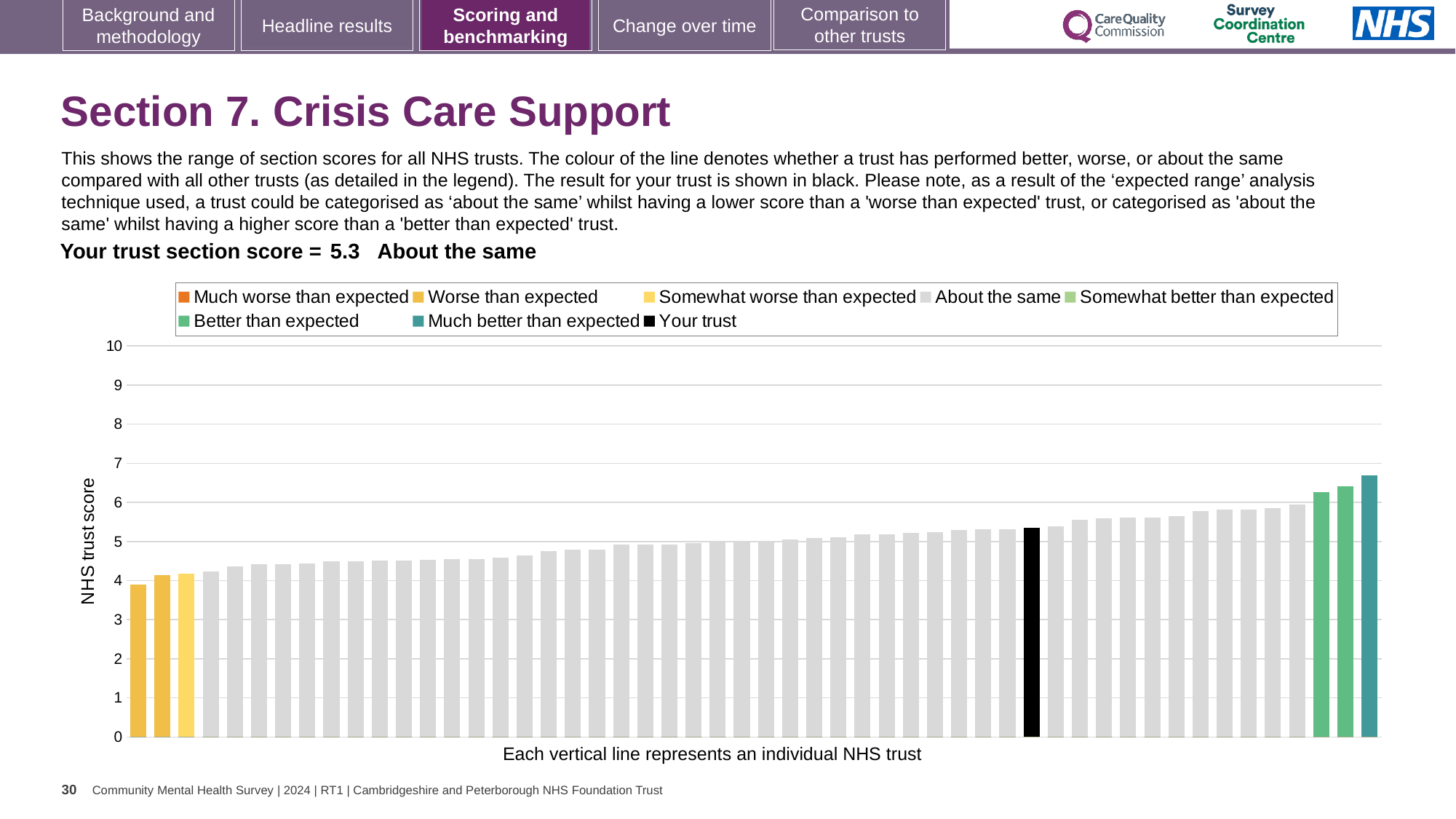
What is the label on the y axis of the chart? NHS trust score Do the bar values rise or fall from left to right along the x axis? rise What is the section score for your trust shown on the slide? 5.3 What kind of chart is shown on the slide? Bar chart Is the value of the tallest bar (rightmost) greater or less than 6? greater How many bars on the right are coloured in the 'better than expected' shades (green/teal)? 3 How many entries does the chart legend list? 8 Is the value for your trust (the black bar) greater or less than 5? greater Which is higher: the rightmost bar or the black bar for your trust? the rightmost bar How many bars on the left are coloured in the 'worse than expected' shades (yellow/orange)? 3 Is the value of the tallest bar (rightmost) greater or less than 7? less Which performance category is your trust placed in for this section? About the same